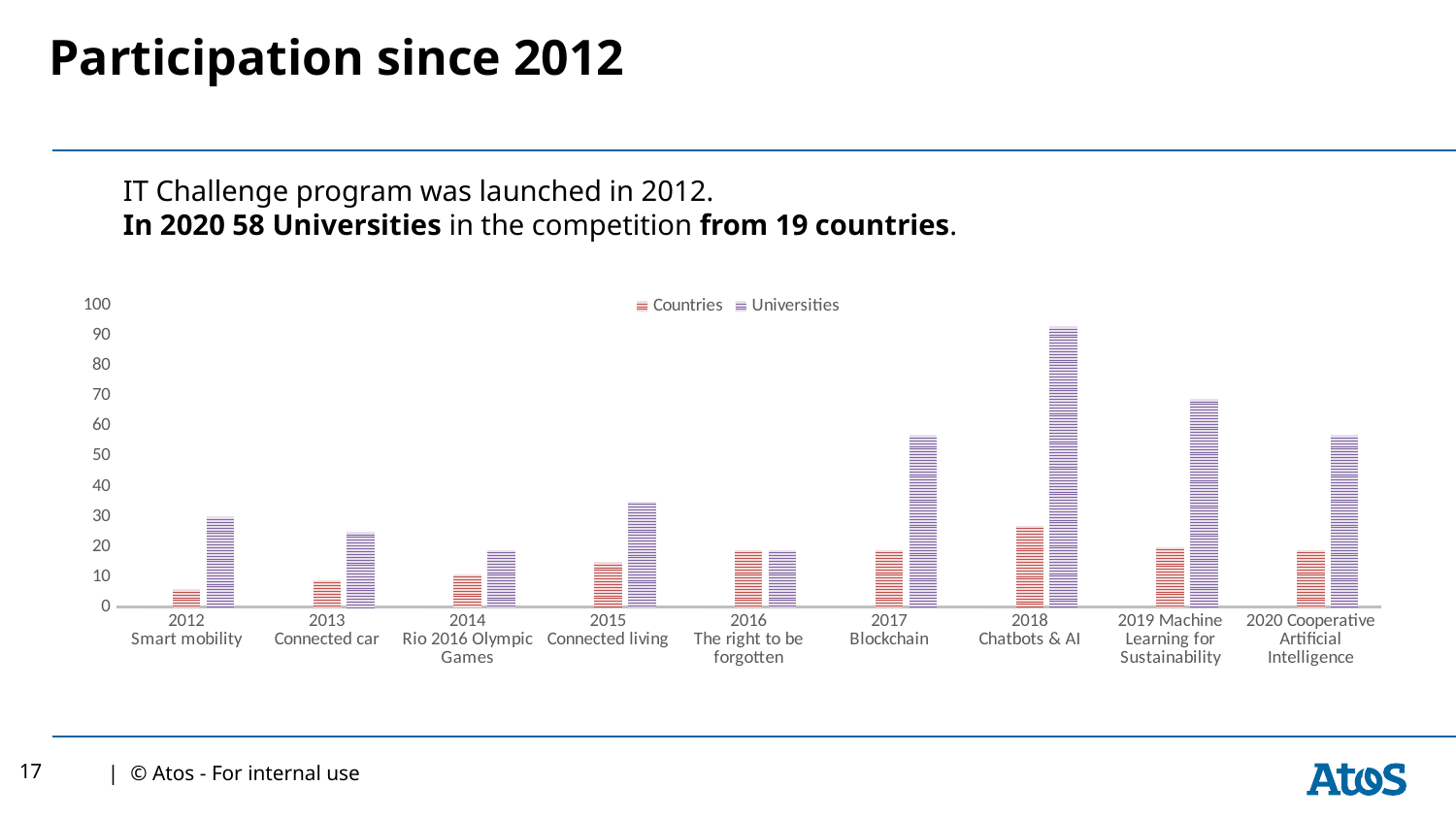
In which year is the Countries bar the lowest? 2012 Is the Countries value for 2012 greater or less than 10? less Is the Universities value for 2017 greater or less than 50? greater What are the two series named in the chart legend? Countries and Universities Is the Universities value for 2018 greater or less than 80? greater Do the Universities values rise or fall from 2018 to 2020? fall How many series does the chart legend list? 2 Which is larger, the Universities value for 2018 or the Universities value for 2019? 2018 What kind of chart is shown on the slide? bar chart How many year categories are shown on the x axis of the chart? 9 In which year is the Universities bar the highest? 2018